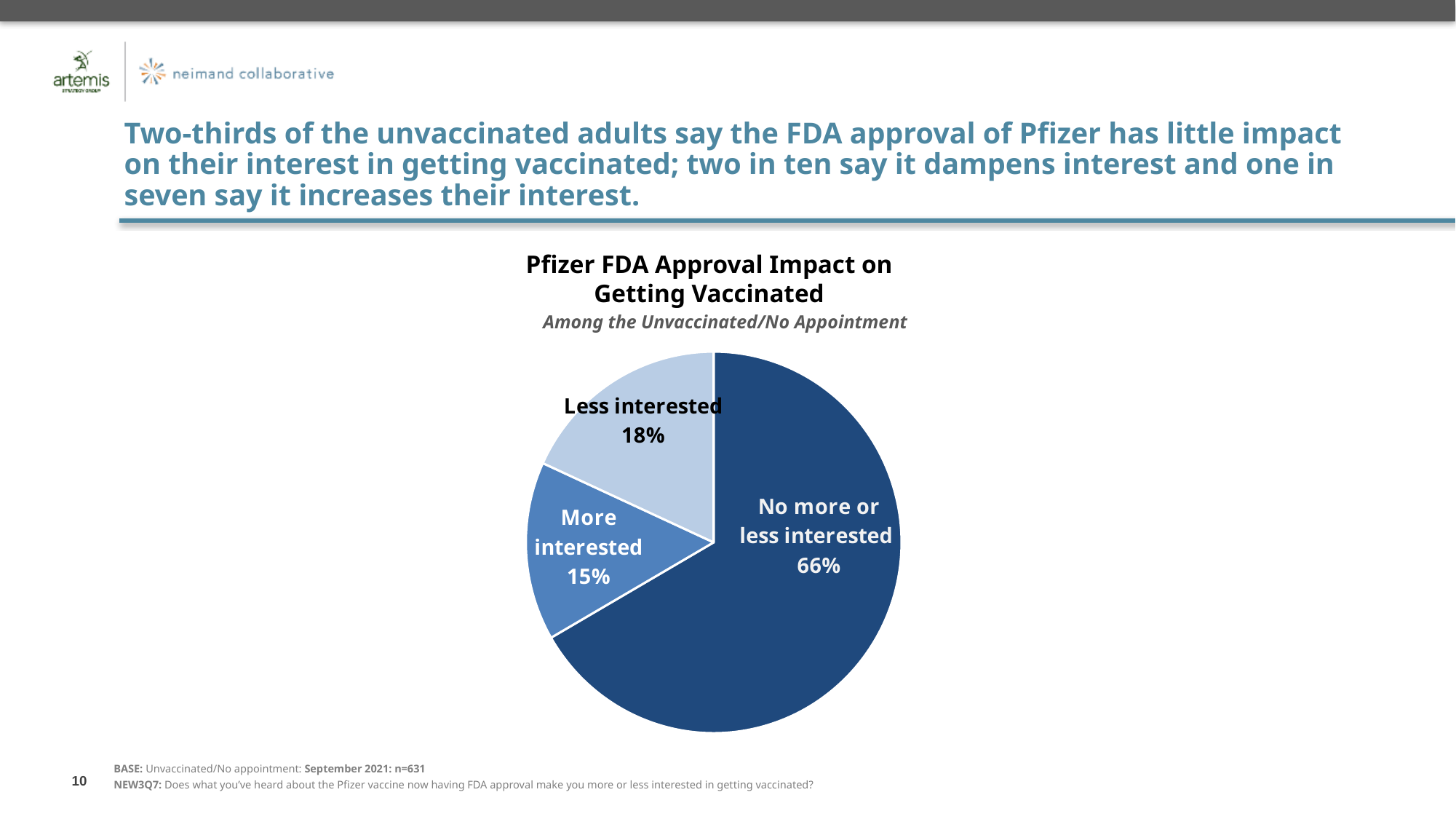
What is the difference in percentage points between 'No more or less interested' and 'Less interested'? 48 Which category has the largest share of the pie? No more or less interested What is the title of the chart? Pfizer FDA Approval Impact on Getting Vaccinated What is the difference in percentage points between 'Less interested' and 'More interested'? 3 What is the subtitle shown under the chart title? Among the Unvaccinated/No Appointment What percentage of respondents say they are less interested? 18% Which category has the smallest share of the pie? More interested Which is larger: the share for 'Less interested' or the share for 'More interested'? Less interested How many slices does the pie chart have? 3 What kind of chart is shown on the slide? Pie chart What percentage of respondents say they are no more or less interested? 66% What percentage of respondents say they are more interested? 15%